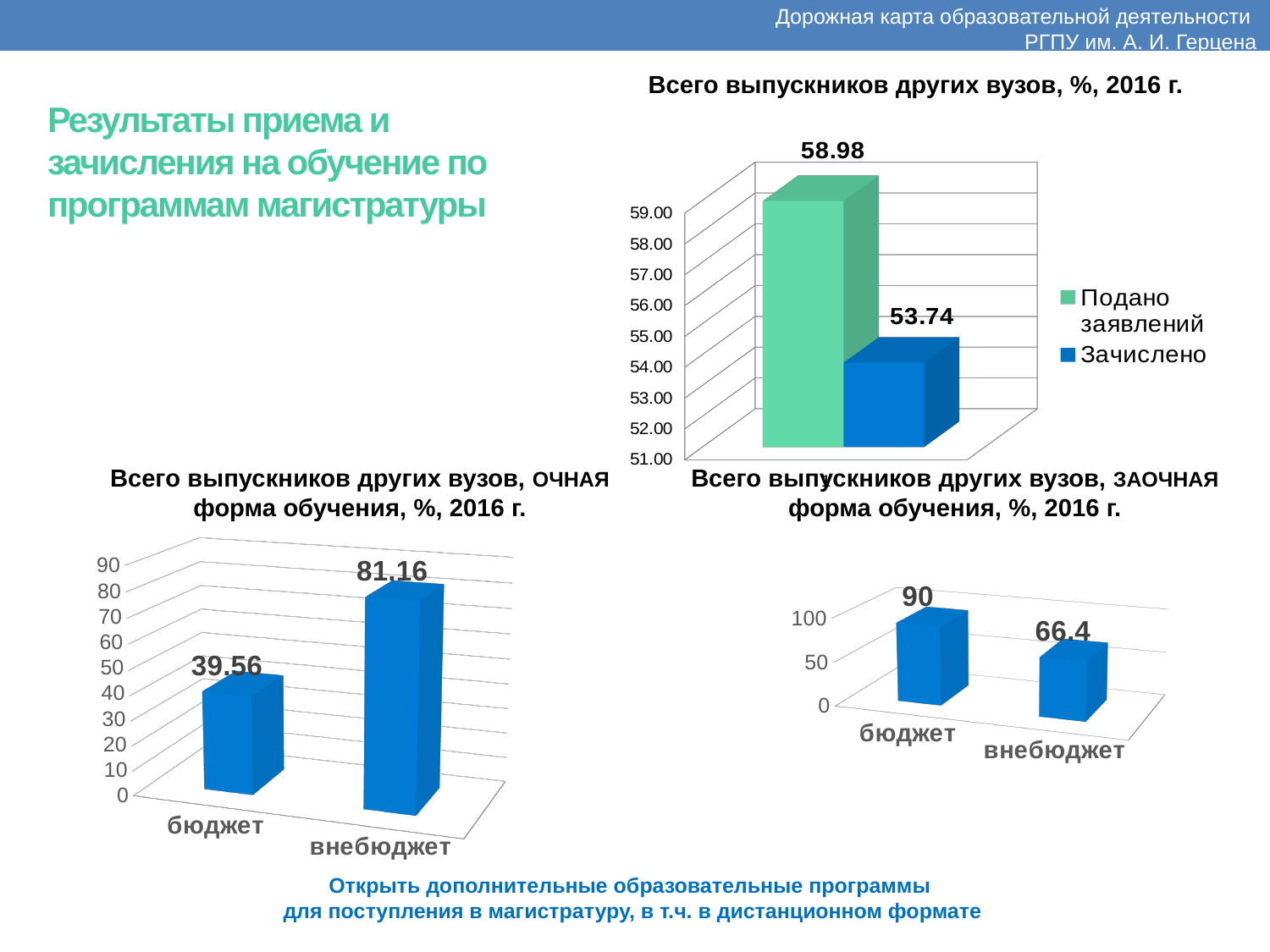
In the chart titled "Всего выпускников других вузов, %, 2016 г.", what is the value for "Подано заявлений"? 58.98 In the chart titled "Всего выпускников других вузов, %, 2016 г.", how many series does the legend list? 2 In the chart titled "Всего выпускников других вузов, ОЧНАЯ форма обучения, %, 2016 г.", what is the value for "бюджет"? 39.56 In the chart titled "Всего выпускников других вузов, ЗАОЧНАЯ форма обучения, %, 2016 г.", what is the value for "бюджет"? 90 In the chart titled "Всего выпускников других вузов, ОЧНАЯ форма обучения, %, 2016 г.", what is the difference between "внебюджет" and "бюджет"? 41.6 In the chart titled "Всего выпускников других вузов, ЗАОЧНАЯ форма обучения, %, 2016 г.", which category has the lowest value? внебюджет In the chart titled "Всего выпускников других вузов, ОЧНАЯ форма обучения, %, 2016 г.", what is the value for "внебюджет"? 81.16 What kind of chart is the one titled "Всего выпускников других вузов, ЗАОЧНАЯ форма обучения, %, 2016 г."? bar chart In the chart titled "Всего выпускников других вузов, %, 2016 г.", what is the difference between "Подано заявлений" and "Зачислено"? 5.24 In the chart titled "Всего выпускников других вузов, %, 2016 г.", which series is larger, "Подано заявлений" or "Зачислено"? Подано заявлений In the chart titled "Всего выпускников других вузов, ОЧНАЯ форма обучения, %, 2016 г.", which category has the highest value? внебюджет In the chart titled "Всего выпускников других вузов, %, 2016 г.", what is the value for "Зачислено"? 53.74